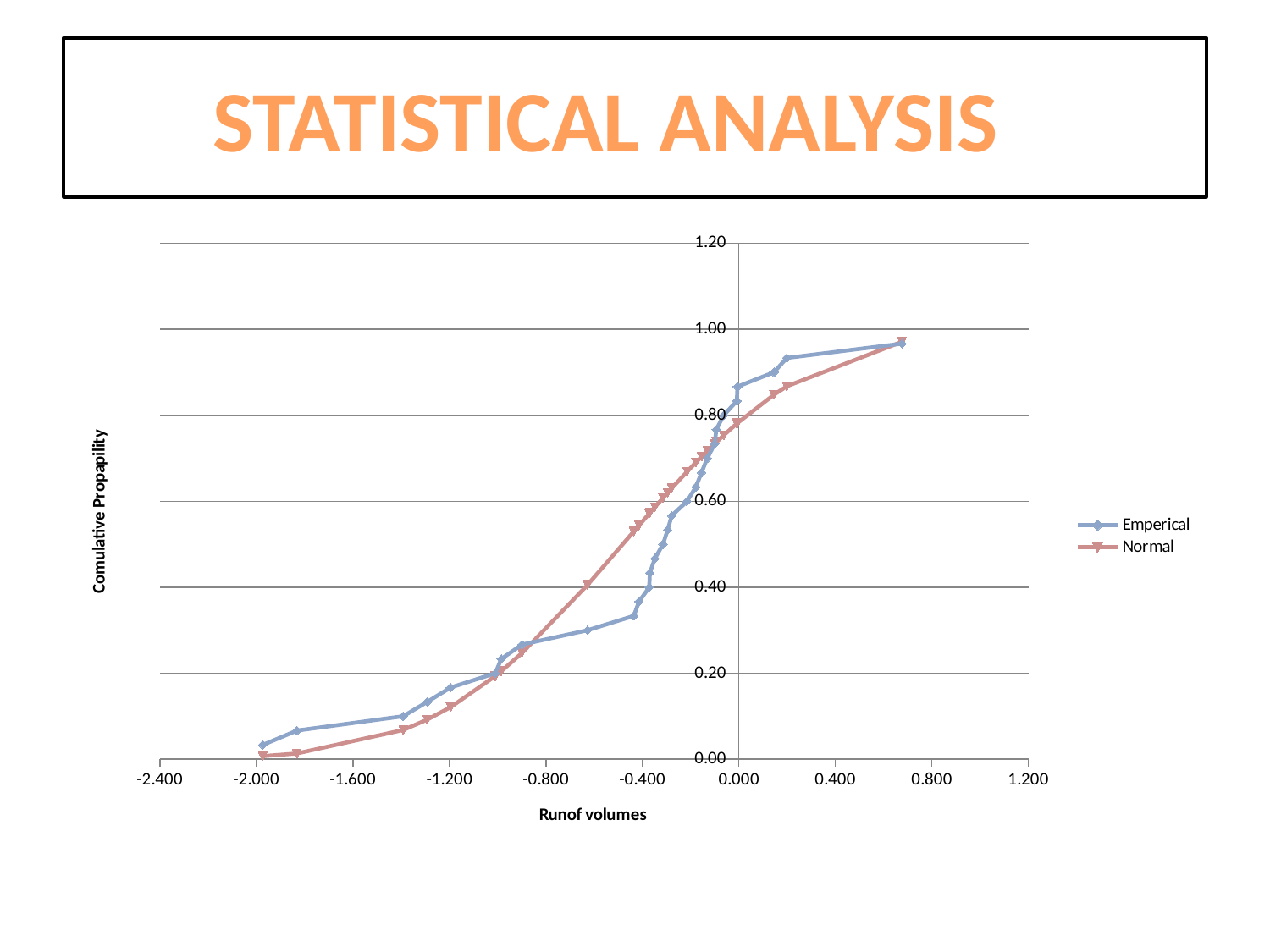
What is the title of the x axis? Runof volumes At a runoff volume of 0.000, which series has the higher cumulative probability, Emperical or Normal? Emperical At a runoff volume of -0.400, which series has the higher cumulative probability, Emperical or Normal? Normal What are the names of the series shown in the legend? Emperical and Normal How many series does the legend list? 2 Is the Normal value at a runoff volume of -1.200 greater or less than 0.20? less Do the values of the Emperical series rise or fall as runoff volume increases along the x axis? rise What kind of chart is shown on the slide? line chart Is the Normal value at a runoff volume of 0.000 greater or less than 0.60? greater Is the Emperical value at a runoff volume of -2.000 greater or less than 0.20? less Do the values of the Normal series rise or fall along the x axis? rise